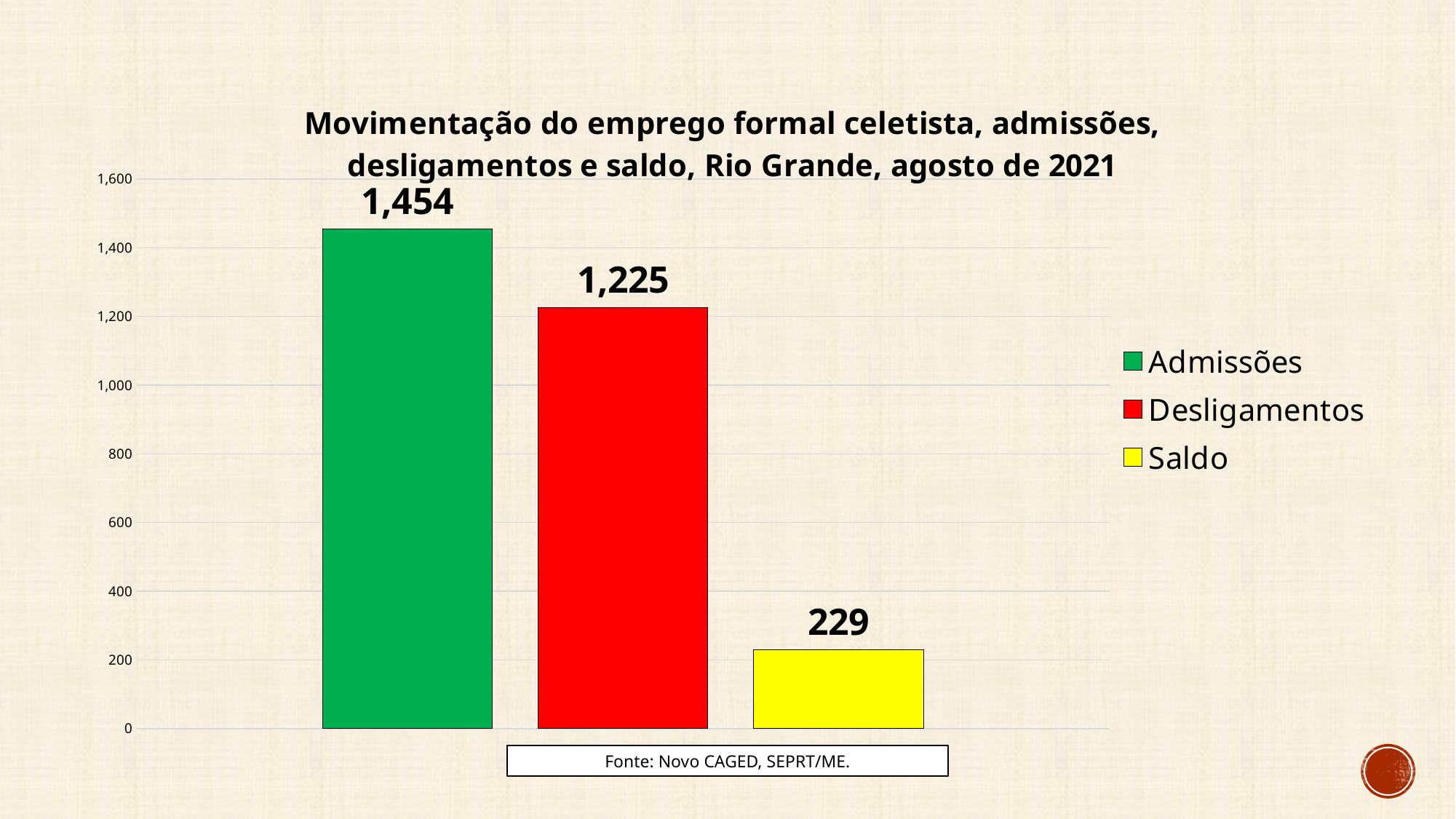
What is the value for Admissões? 1,454 Which series has the highest value? Admissões What colour is the bar for Saldo? yellow Is the value for Desligamentos greater or less than 1,200? greater Which series has the lowest value? Saldo What is the value for Desligamentos? 1,225 How many bars are plotted in the chart? 3 What kind of chart is shown on the slide? bar chart How many series does the legend list? 3 What is the value for Saldo? 229 Which is larger, Desligamentos or Saldo? Desligamentos What is the difference between Admissões and Desligamentos? 229